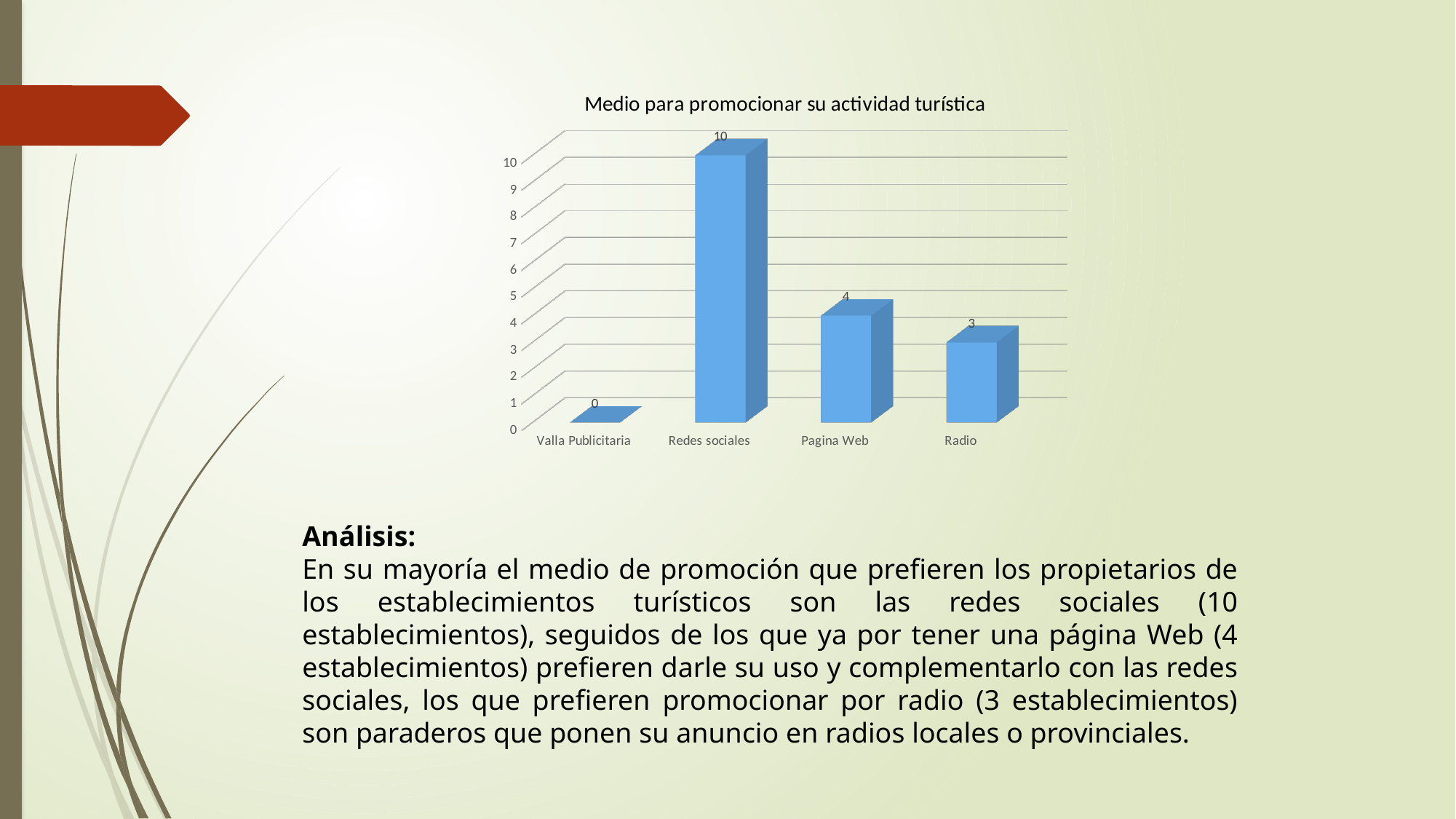
What is the value for Radio? 3 Which is larger, the value for Pagina Web or the value for Radio? Pagina Web Which category has the highest value? Redes sociales What is the value for Pagina Web? 4 What kind of chart is shown on the slide? Bar chart How many categories are shown on the x axis? 4 What is the total of the values for Pagina Web and Radio? 7 What is the title of the chart? Medio para promocionar su actividad turística Which category has the lowest value? Valla Publicitaria What is the value for Valla Publicitaria? 0 What is the value for Redes sociales? 10 What is the difference between the values for Redes sociales and Pagina Web? 6